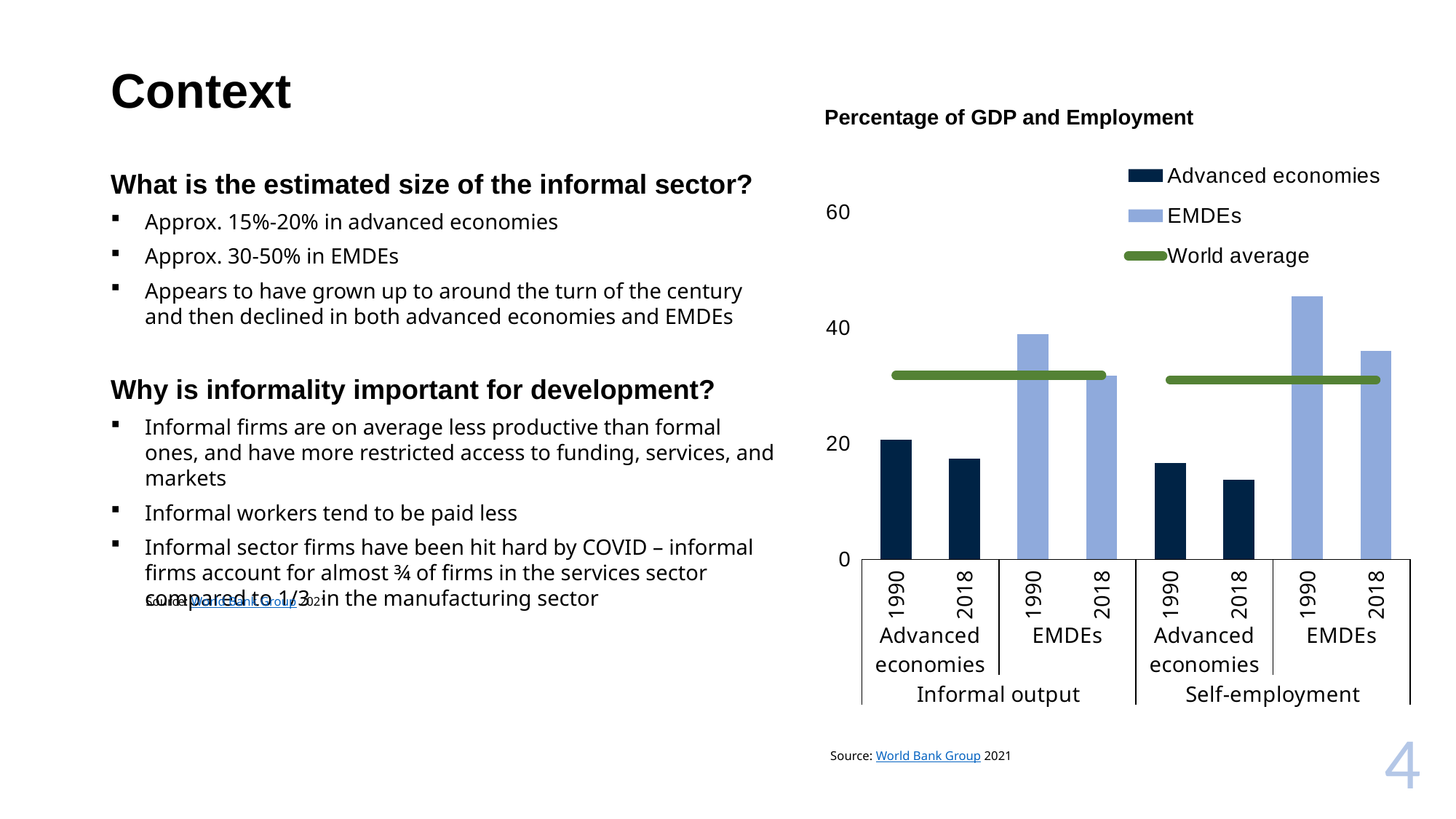
How many series does the chart legend list? 3 Under Informal output, which is larger for EMDEs: the 1990 value or the 2018 value? 1990 What kind of chart is shown on the slide? combination bar and line chart Is the value for EMDEs in 2018 under Self-employment greater or less than 40? less Under Self-employment, do the Advanced economies values rise or fall from 1990 to 2018? fall Which bar is the highest in the chart? EMDEs 1990 (Self-employment) Which legend entry is shown as a green line rather than bars? World average Is the value for Advanced economies in 2018 under Informal output greater or less than 20? less Which bar is the lowest in the chart? Advanced economies 2018 (Self-employment) What is the title of the chart? Percentage of GDP and Employment How many bars are plotted in the chart? 8 Is the value for EMDEs in 1990 under Self-employment greater or less than 40? greater